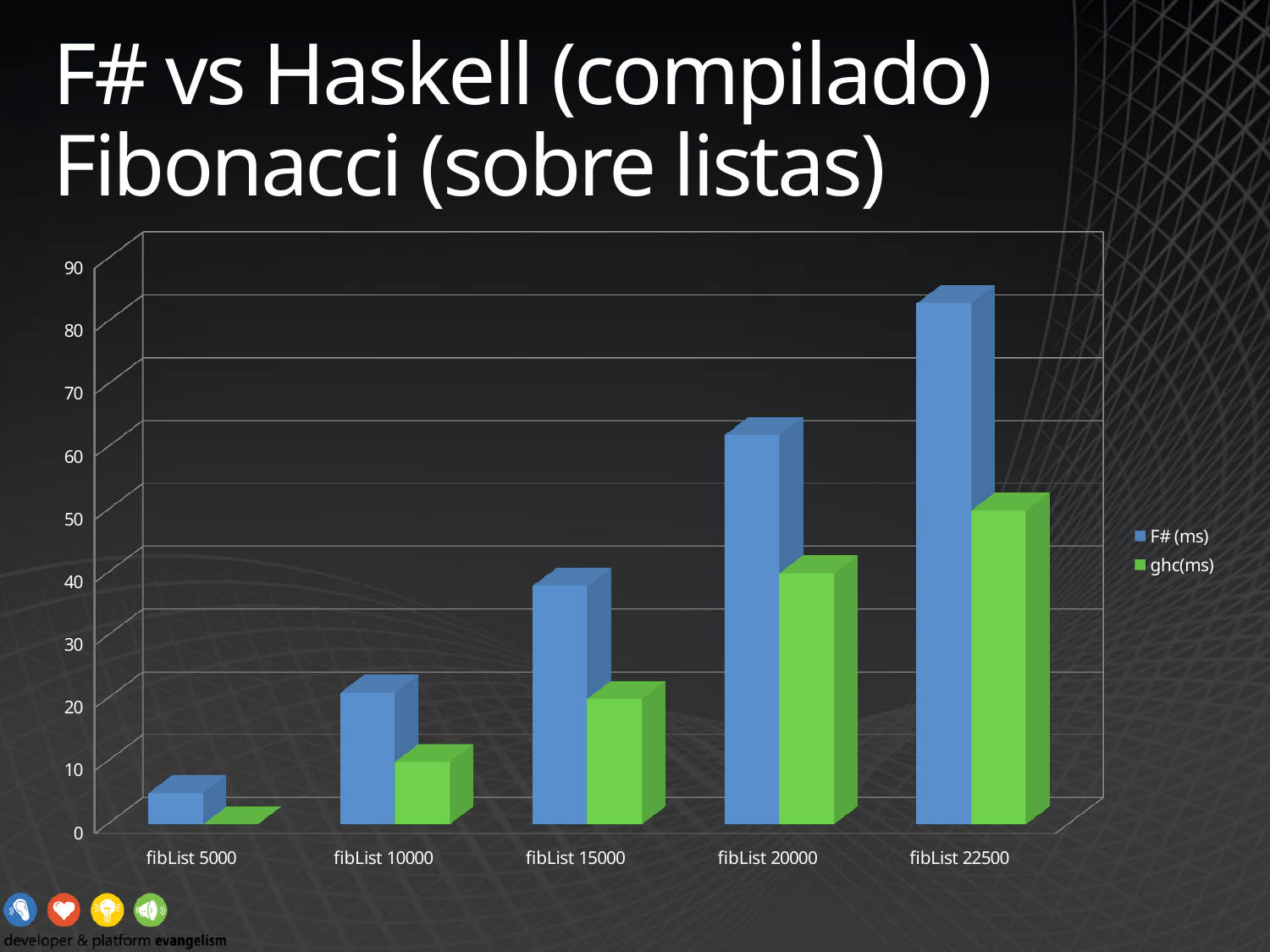
Which category has the highest F# (ms) value? fibList 22500 How many categories are shown on the x axis? 5 At fibList 20000, which series has the larger value, F# (ms) or ghc(ms)? F# (ms) Which category has the lowest ghc(ms) value? fibList 5000 What kind of chart is shown on the slide? bar chart How many series does the legend list? 2 Do the F# (ms) values rise or fall as the list size increases along the x axis? rise Is the F# (ms) value for fibList 22500 greater or less than 70? greater What colour are the ghc(ms) bars? green Is the ghc(ms) value for fibList 22500 greater or less than 40? greater Is the F# (ms) value for fibList 20000 greater or less than 70? less